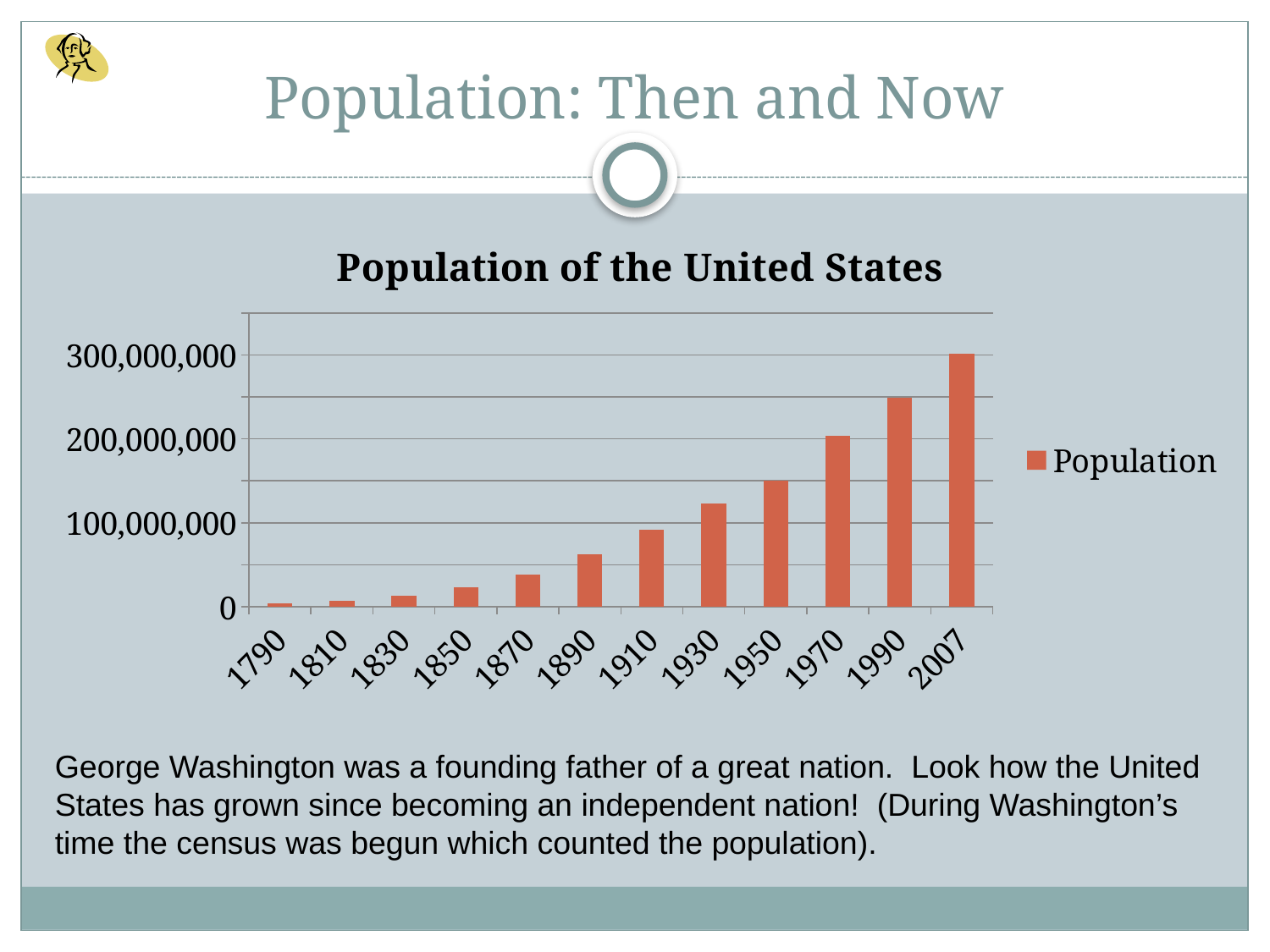
Which year has the lowest population in the chart? 1790 What is the title of the chart? Population of the United States Is the population for 1930 greater or less than 200,000,000? less Is the population for 1890 greater or less than 100,000,000? less How many years are shown on the x axis of the chart? 12 Does the population rise or fall from 1790 to 2007 along the x axis? rise How many series does the chart's legend list? 1 What kind of chart is shown on the slide? bar chart Is the population for 1950 greater or less than 100,000,000? greater Which year has the larger population, 1990 or 1950? 1990 What is the name of the series shown in the legend? Population Which year has the highest population in the chart? 2007